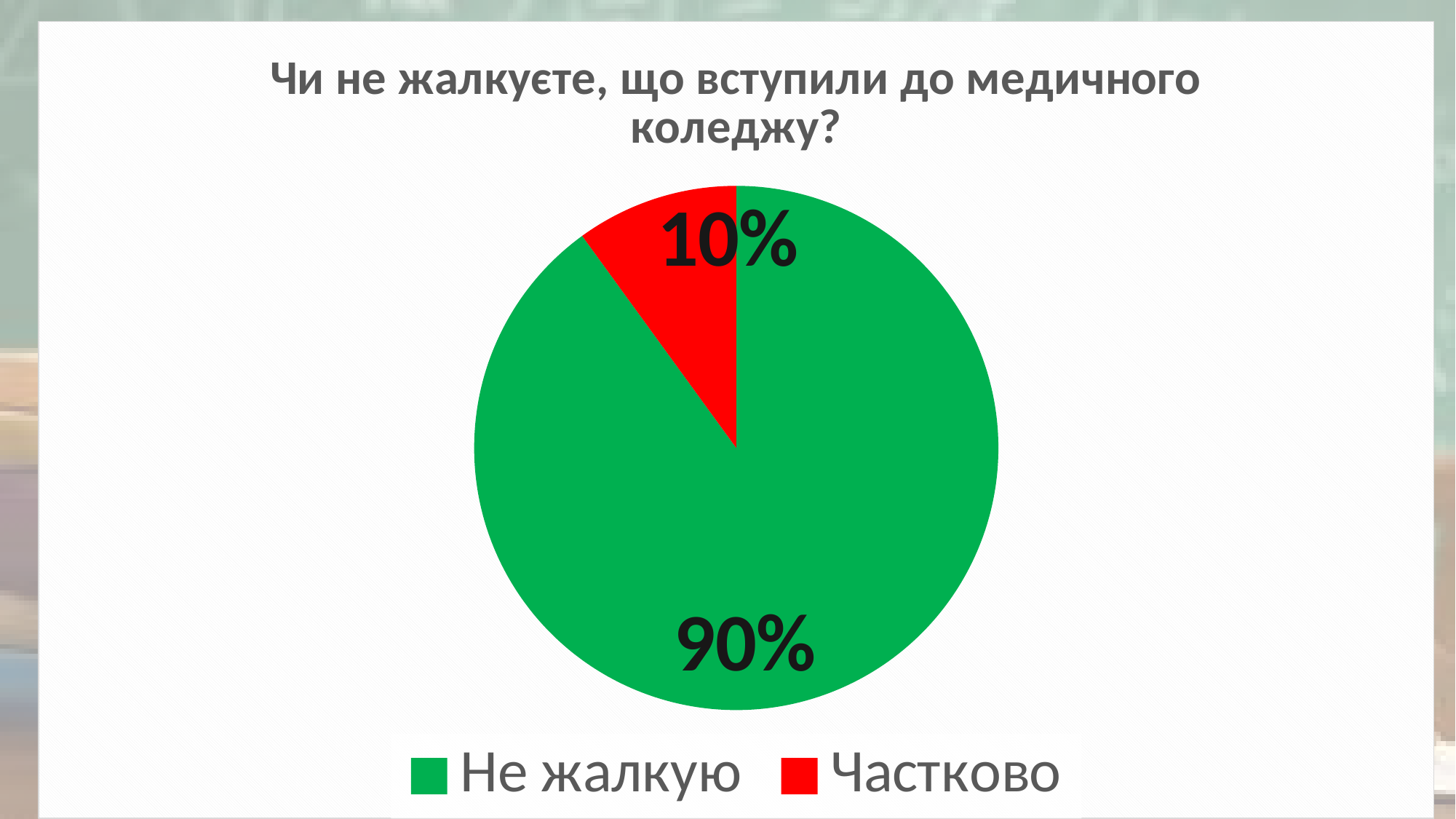
What is the difference in percentage points between "Не жалкую" and "Частково"? 80 Which is larger, the share for "Не жалкую" or the share for "Частково"? Не жалкую What percentage of the pie is labelled "Частково"? 10% What is the title of the chart? Чи не жалкуєте, що вступили до медичного коледжу? What percentage of the pie is labelled "Не жалкую"? 90% What share of the pie does the "Не жалкую" slice represent? 90% Which category has the smallest share of the pie? Частково What colour is the slice for "Частково"? red Which category has the largest share of the pie? Не жалкую What kind of chart is shown on the slide? pie chart How many slices does the pie chart have? 2 How many entries does the legend list? 2